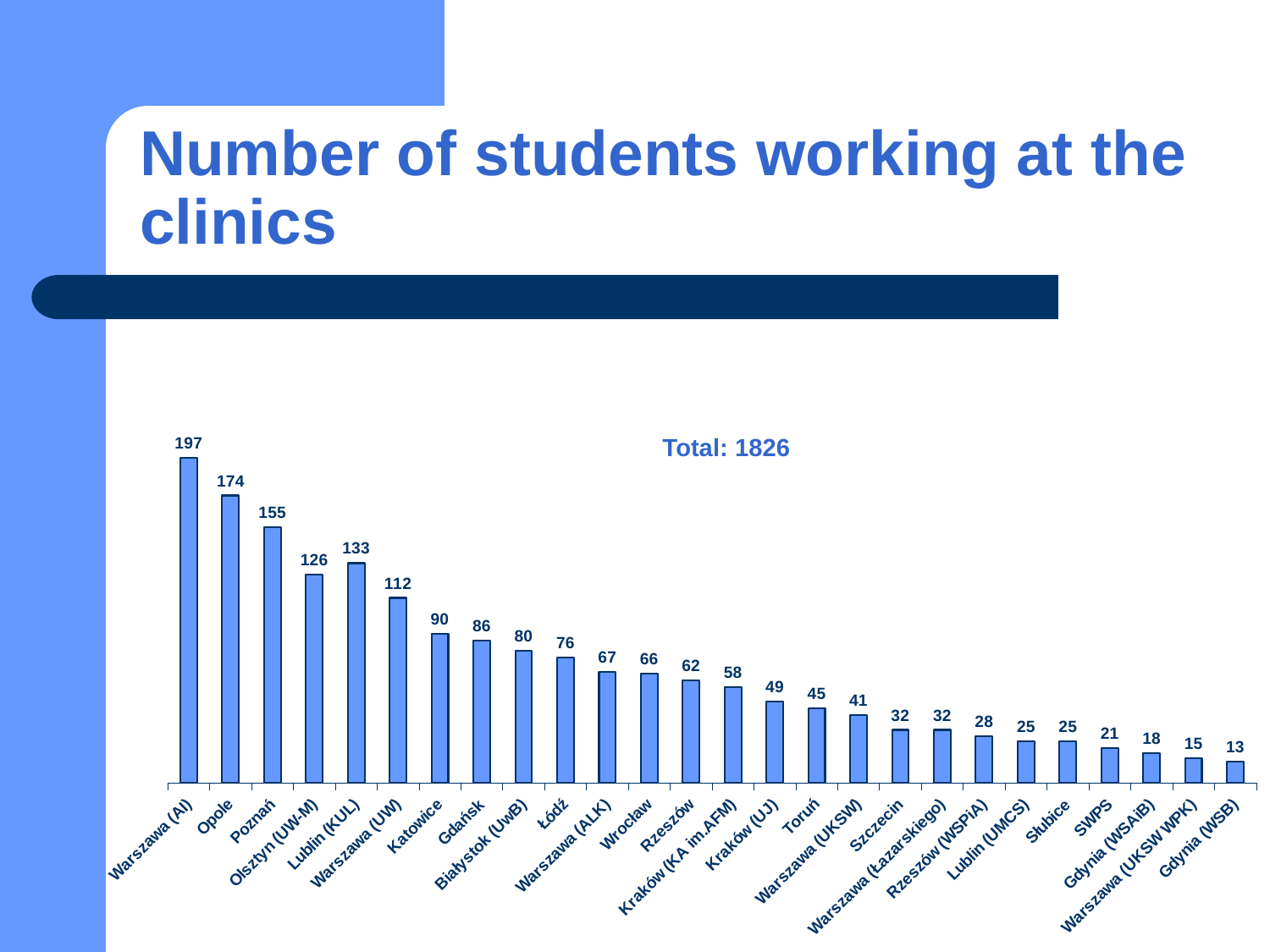
Which clinic has the highest number of students? Warszawa (AI) What is the difference between the values for Katowice and Gdańsk? 4 Which has more students, Olsztyn (UW-M) or Lublin (KUL)? Lublin (KUL) What total number of students is stated on the chart? 1826 What is the value shown for Kraków (UJ)? 49 Which has more students, Toruń or Szczecin? Toruń What is the value shown for Lublin (KUL)? 133 How many students work at the clinic in Opole? 174 What kind of chart is shown on the slide? Bar chart What is the difference between the values for Warszawa (AI) and Opole? 23 Which clinic has the lowest number of students? Gdynia (WSB) How many clinics are shown on the chart? 26